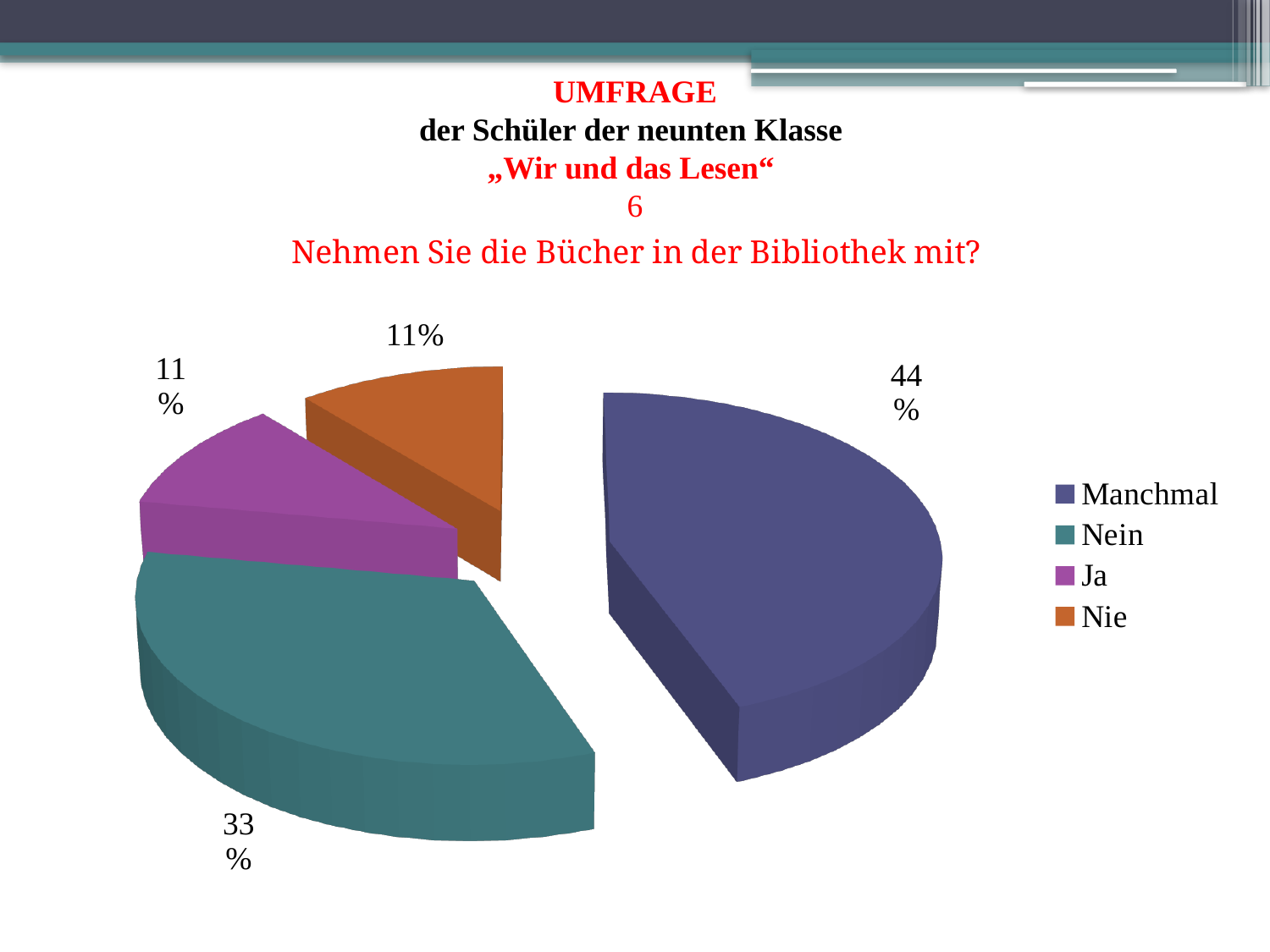
Which is larger, the share for Nein or the share for Ja? Nein How many slices does the pie chart have? 4 How many entries does the legend list? 4 Which legend entry is shown in orange? Nie What kind of chart is shown on the slide? pie chart What percentage of the pie is labelled for Ja? 11% Which category has the largest share of the pie? Manchmal What percentage of the pie is labelled for Nein? 33% What percentage of the pie is labelled for Nie? 11% What is the difference in percentage points between Manchmal and Nein? 11 What percentage of the pie is labelled for Manchmal? 44% What is the combined share of Ja and Nie? 22%